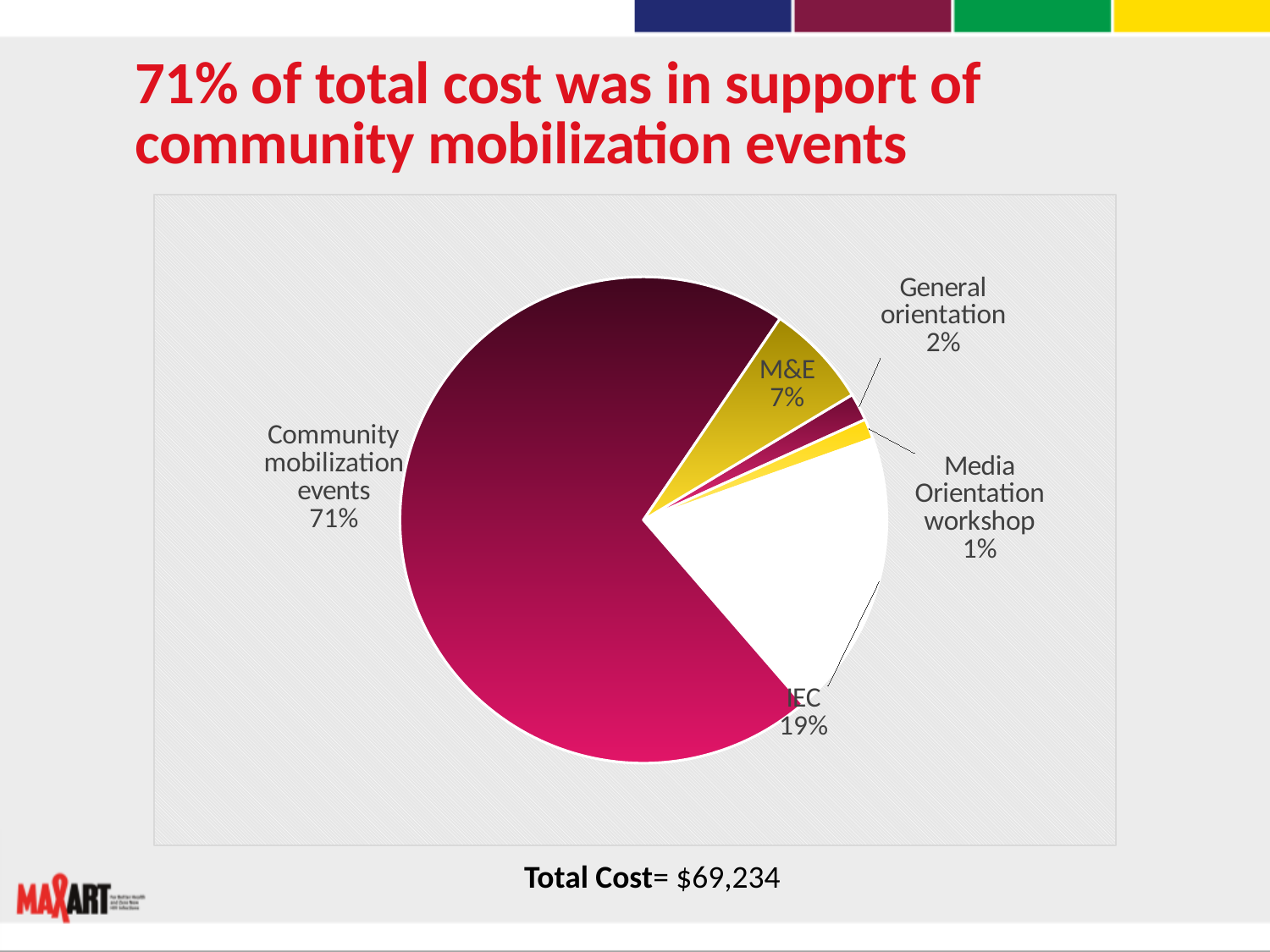
What share of total cost went to M&E? 7% What total cost is stated below the chart? $69,234 Which category has the largest share of total cost? Community mobilization events What share of total cost went to the Media Orientation workshop? 1% What share of total cost went to IEC? 19% Which category has the smallest share of total cost? Media Orientation workshop What kind of chart is shown on the slide? pie chart Which has a larger share of total cost, M&E or General orientation? M&E What is the difference in percentage points between the Community mobilization events share and the IEC share? 52 percentage points How many categories are shown in the pie chart? 5